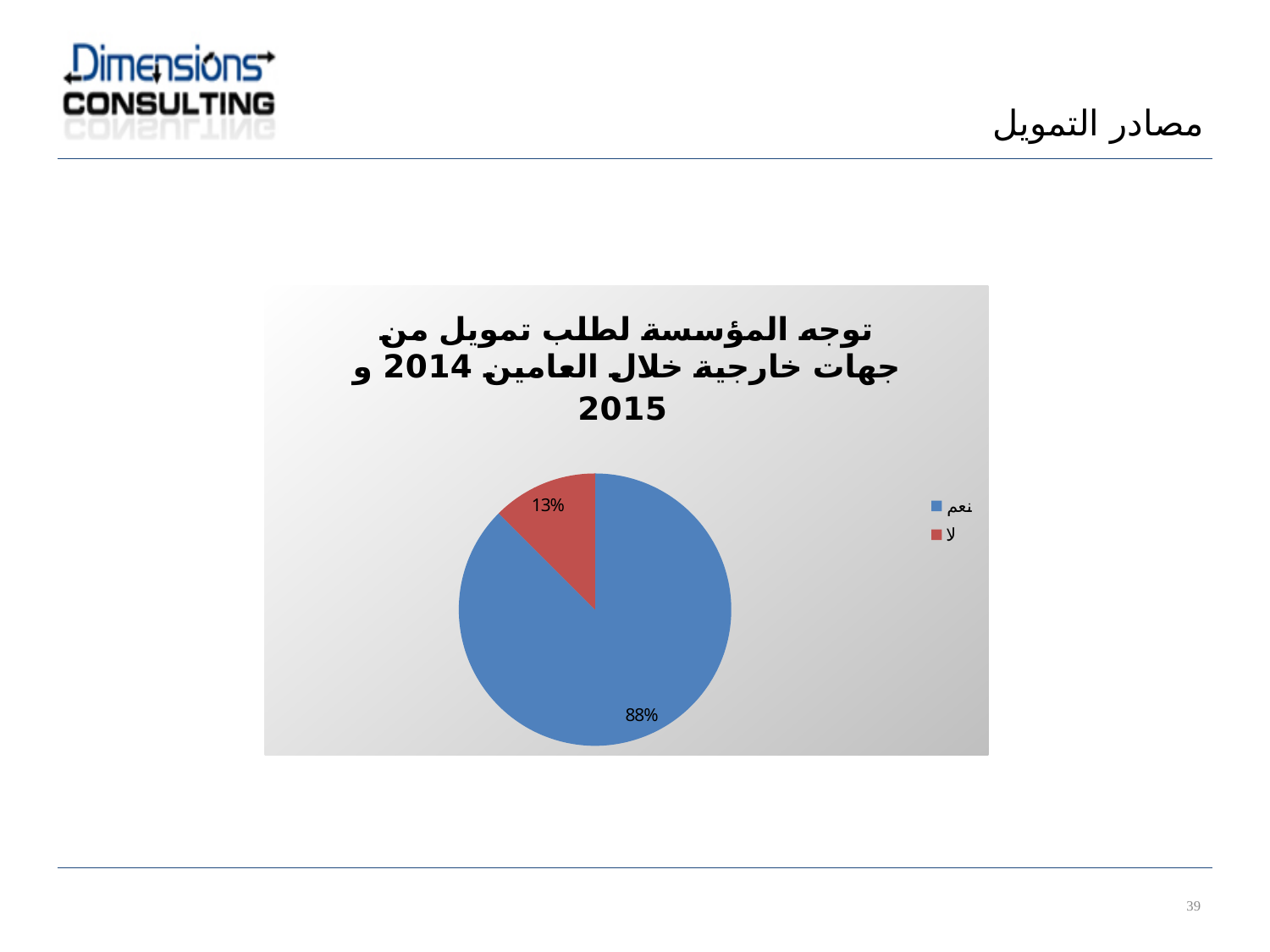
What is the difference in percentage points between the "نعم" slice and the "لا" slice? 75 How many slices does the pie chart have? 2 What colour is the "لا" slice in the pie chart? Red What percentage of the pie is labelled for the "نعم" slice? 88% What kind of chart is shown on the slide? Pie chart What colour is the "نعم" slice in the pie chart? Blue Which slice of the pie is the largest? نعم How many entries does the legend list? 2 Which is larger, the "نعم" slice or the "لا" slice? نعم What percentage of the pie is labelled for the "لا" slice? 13% What share of the pie does the "لا" slice represent? 13% Which slice of the pie is the smallest? لا